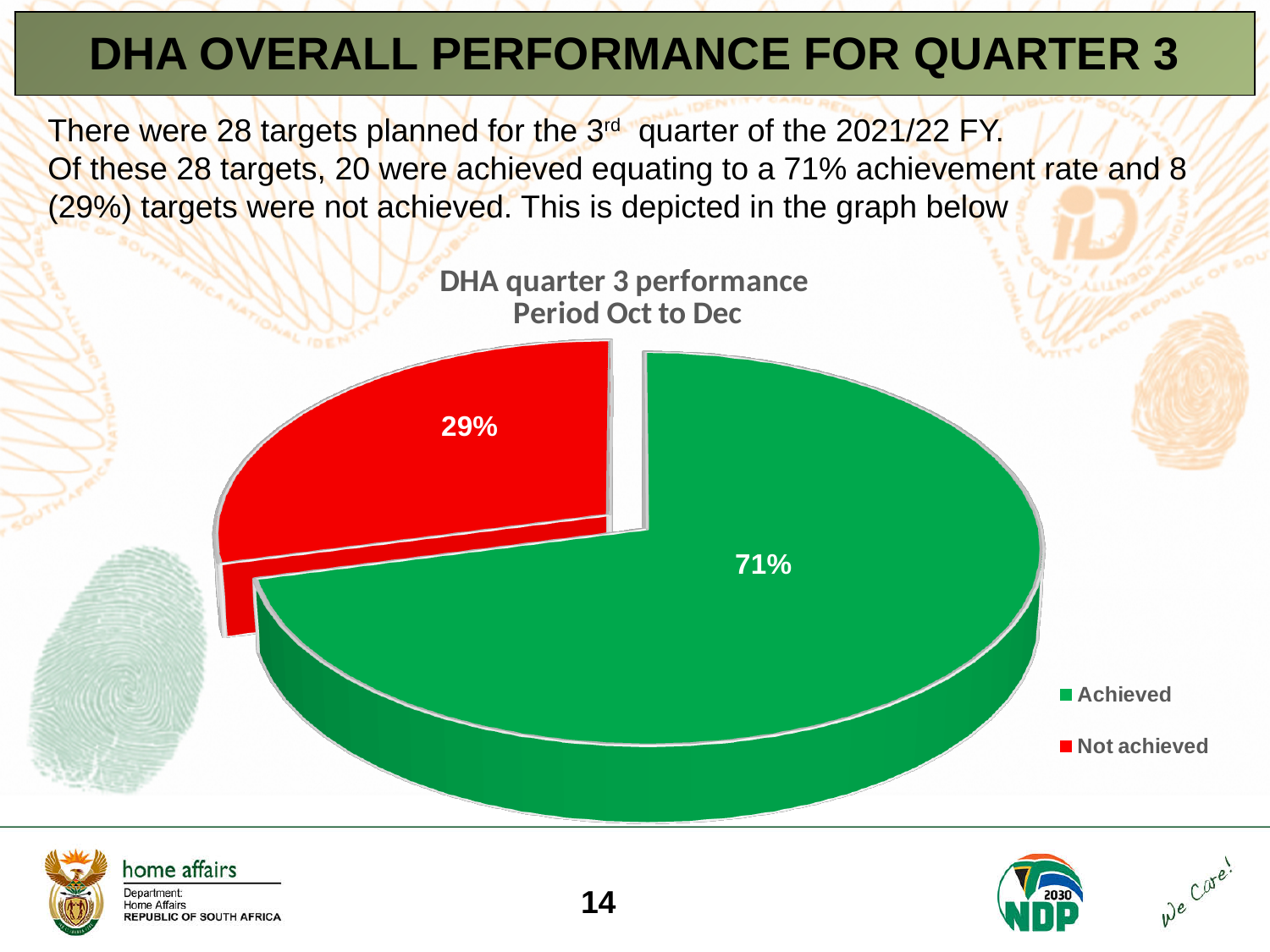
Which slice of the pie is the largest? Achieved What is the difference in percentage points between the Achieved and Not achieved slices? 42 How many slices does the pie chart have? 2 What percentage of the pie is labelled for Achieved? 71% Which is larger, the Achieved slice or the Not achieved slice? Achieved What colour is the Not achieved slice? Red How many entries does the legend list? 2 What percentage of the pie is labelled for Not achieved? 29% What kind of chart is shown on the slide? Pie chart What is the title of the chart? DHA quarter 3 performance Period Oct to Dec Which slice of the pie is the smallest? Not achieved What share of the pie does the Achieved slice represent? 71%